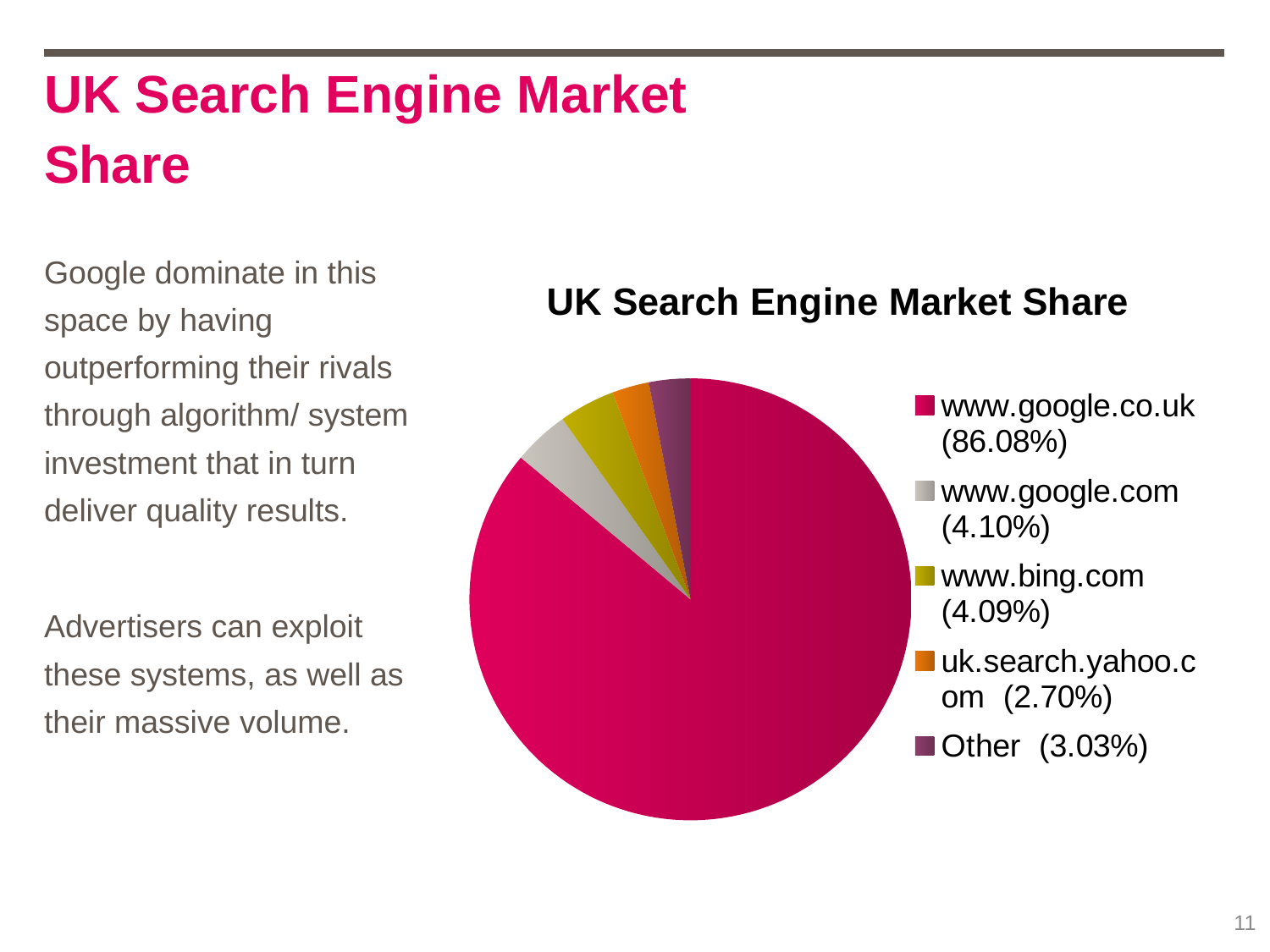
Which category has the smallest slice of the pie? uk.search.yahoo.com What share of the UK search engine market does www.google.co.uk hold according to the chart? 86.08% What type of chart is shown on the slide? Pie chart Which search engine has the largest slice of the pie? www.google.co.uk What is the title of the chart? UK Search Engine Market Share What is the difference in share between www.google.co.uk and www.google.com? 81.98% What share is shown for the Other category? 3.03% What share is shown for uk.search.yahoo.com? 2.70% How many categories does the pie chart show? 5 What share is shown for www.bing.com? 4.09% Which is larger, the share for Other or the share for uk.search.yahoo.com? Other What colour is the slice for www.google.co.uk? Pink/magenta